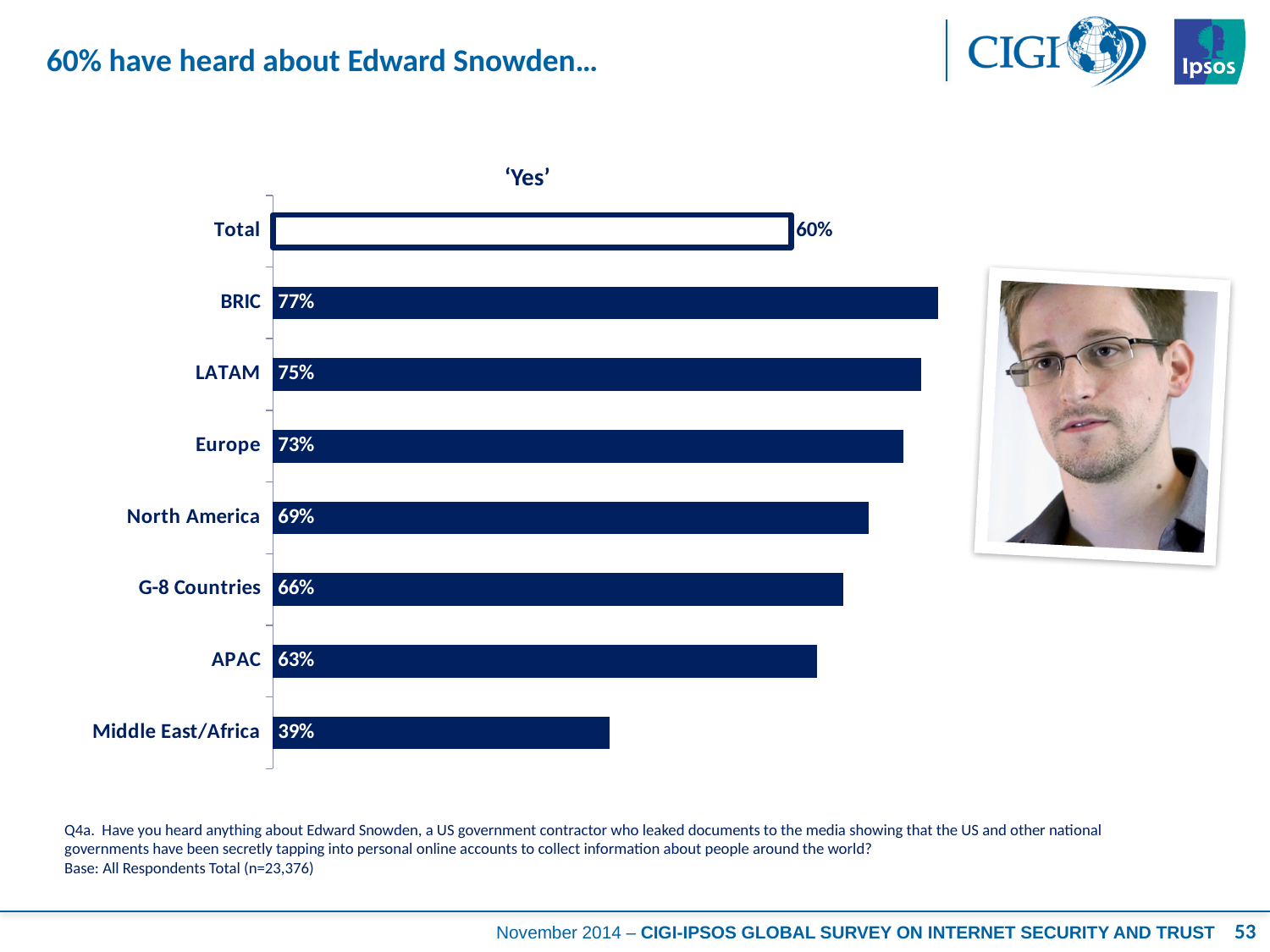
What is the difference between the values for BRIC and Middle East/Africa? 38% What is the value for North America? 69% What type of chart is shown on the slide? Bar chart What is the Total value shown on the chart? 60% How many bars are shown on the chart, including Total? 8 Which region has the lowest percentage of 'Yes' responses? Middle East/Africa What percentage of respondents in BRIC answered 'Yes'? 77% What is the difference between the values for Europe and APAC? 10% What is the value shown for Middle East/Africa? 39% Which region has the highest percentage of 'Yes' responses? BRIC Which is larger, the value for LATAM or the value for G-8 Countries? LATAM What is the title shown above the chart? 'Yes'